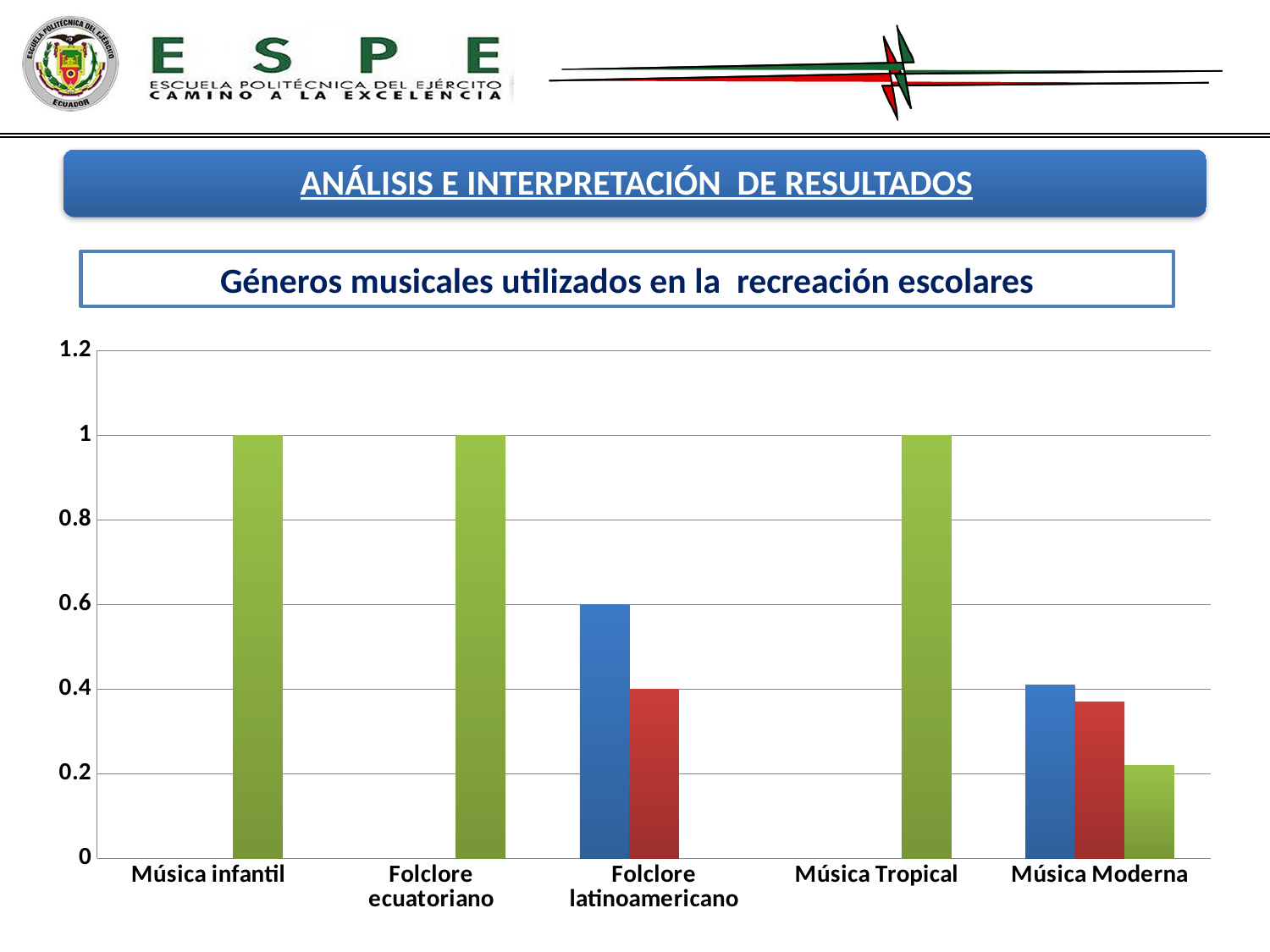
What is the value of the green bar for Música infantil? 1 What is the value of the green bar for Música Tropical? 1 How many categories are shown on the x axis of the chart? 5 For Folclore latinoamericano, which is larger, the blue bar or the red bar? the blue bar What is the value of the blue bar for Folclore latinoamericano? 0.6 Which category has the lowest green bar? Música Moderna What is the difference between the blue bar and the red bar for Folclore latinoamericano? 0.2 What is the value of the red bar for Folclore latinoamericano? 0.4 Is the value of the green bar for Música Moderna greater or less than 0.4? less Is the value of the blue bar for Música Moderna greater or less than 0.6? less What is the title shown above the chart? Géneros musicales utilizados en la recreación escolares What kind of chart is shown on the slide? bar chart